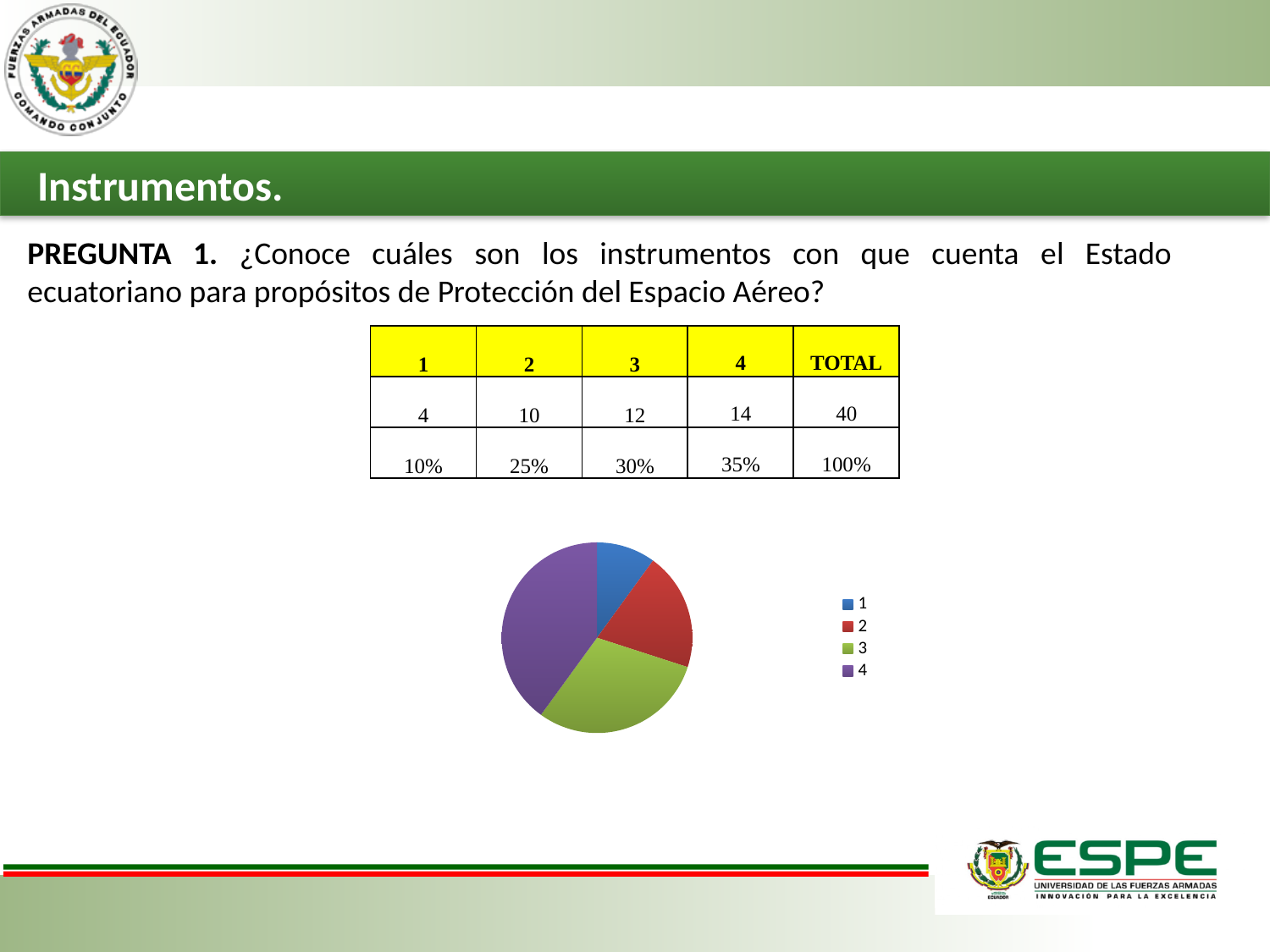
How many slices does the pie chart have? 4 Which slice is larger in the pie chart, category 1 or category 4? 4 Which category has the smallest slice in the pie chart? 1 Which category has the largest slice in the pie chart? 4 According to the table above the pie chart, what share of the total does category 1 represent? 10% According to the table above the pie chart, how many responses does category 3 have? 12 What colour is the slice for category 3 in the pie chart? green Which slice is larger in the pie chart, category 2 or category 3? 3 What kind of chart is shown on the slide? pie chart According to the table above the pie chart, what share of the total does category 4 represent? 35% How many entries does the pie chart's legend list? 4 According to the table above the pie chart, what is the total number of responses? 40